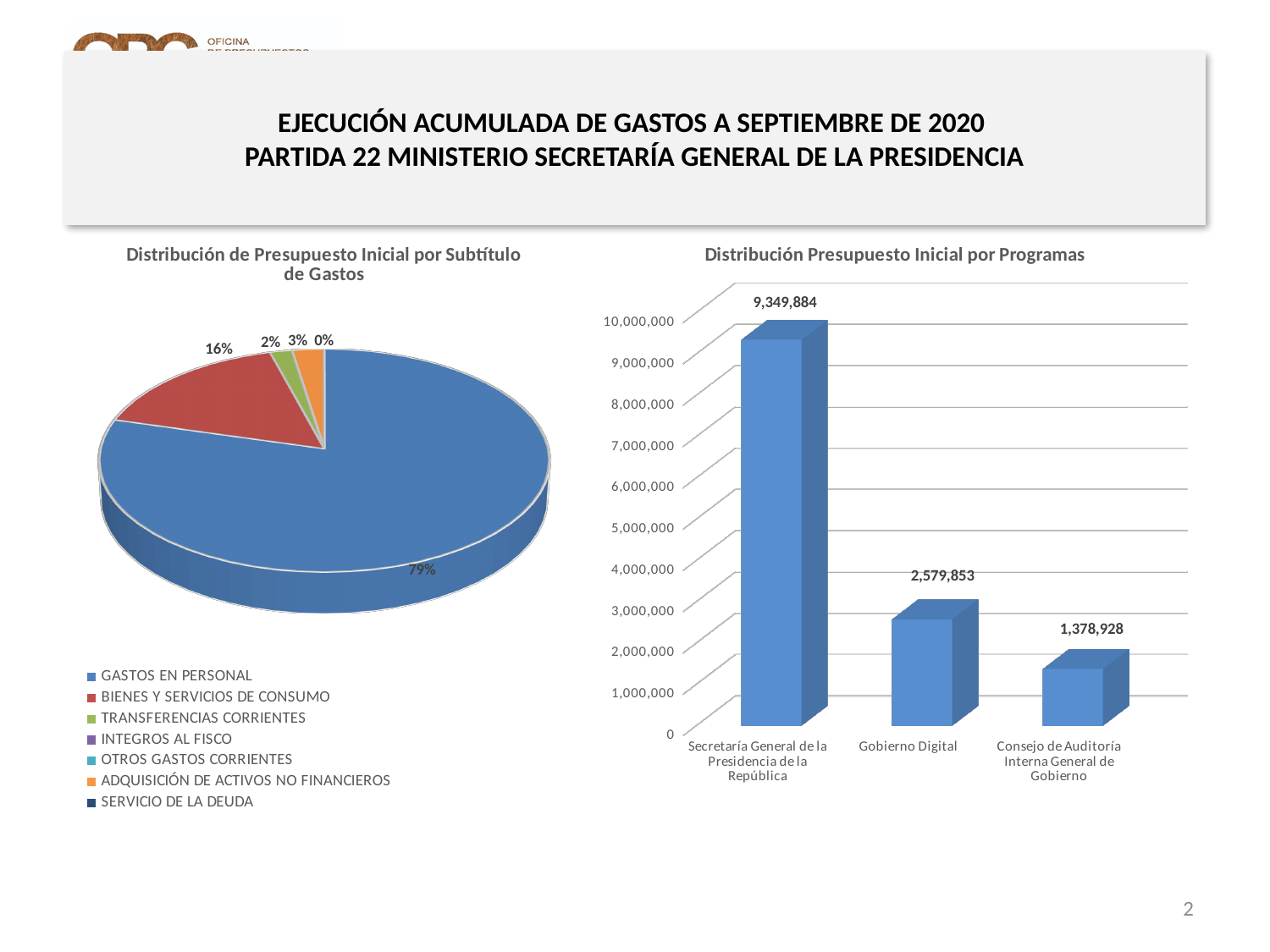
On the 'Distribución Presupuesto Inicial por Programas' chart, do the values rise or fall from left to right? Fall On the pie chart 'Distribución de Presupuesto Inicial por Subtítulo de Gastos', what share does BIENES Y SERVICIOS DE CONSUMO have? 16% On the 'Distribución Presupuesto Inicial por Programas' chart, which program has the lowest value? Consejo de Auditoría Interna General de Gobierno What kind of chart is 'Distribución Presupuesto Inicial por Programas'? Bar chart On the 'Distribución Presupuesto Inicial por Programas' chart, what is the value for Secretaría General de la Presidencia de la República? 9,349,884 On the 'Distribución Presupuesto Inicial por Programas' chart, which program has the highest value? Secretaría General de la Presidencia de la República On the pie chart 'Distribución de Presupuesto Inicial por Subtítulo de Gastos', what share does GASTOS EN PERSONAL have? 79% On the 'Distribución Presupuesto Inicial por Programas' chart, what is the value for Gobierno Digital? 2,579,853 How many entries does the legend of the pie chart 'Distribución de Presupuesto Inicial por Subtítulo de Gastos' list? 7 On the 'Distribución Presupuesto Inicial por Programas' chart, what is the difference between Gobierno Digital and Consejo de Auditoría Interna General de Gobierno? 1,200,925 On the 'Distribución Presupuesto Inicial por Programas' chart, how many programs are shown? 3 On the 'Distribución Presupuesto Inicial por Programas' chart, what is the value for Consejo de Auditoría Interna General de Gobierno? 1,378,928